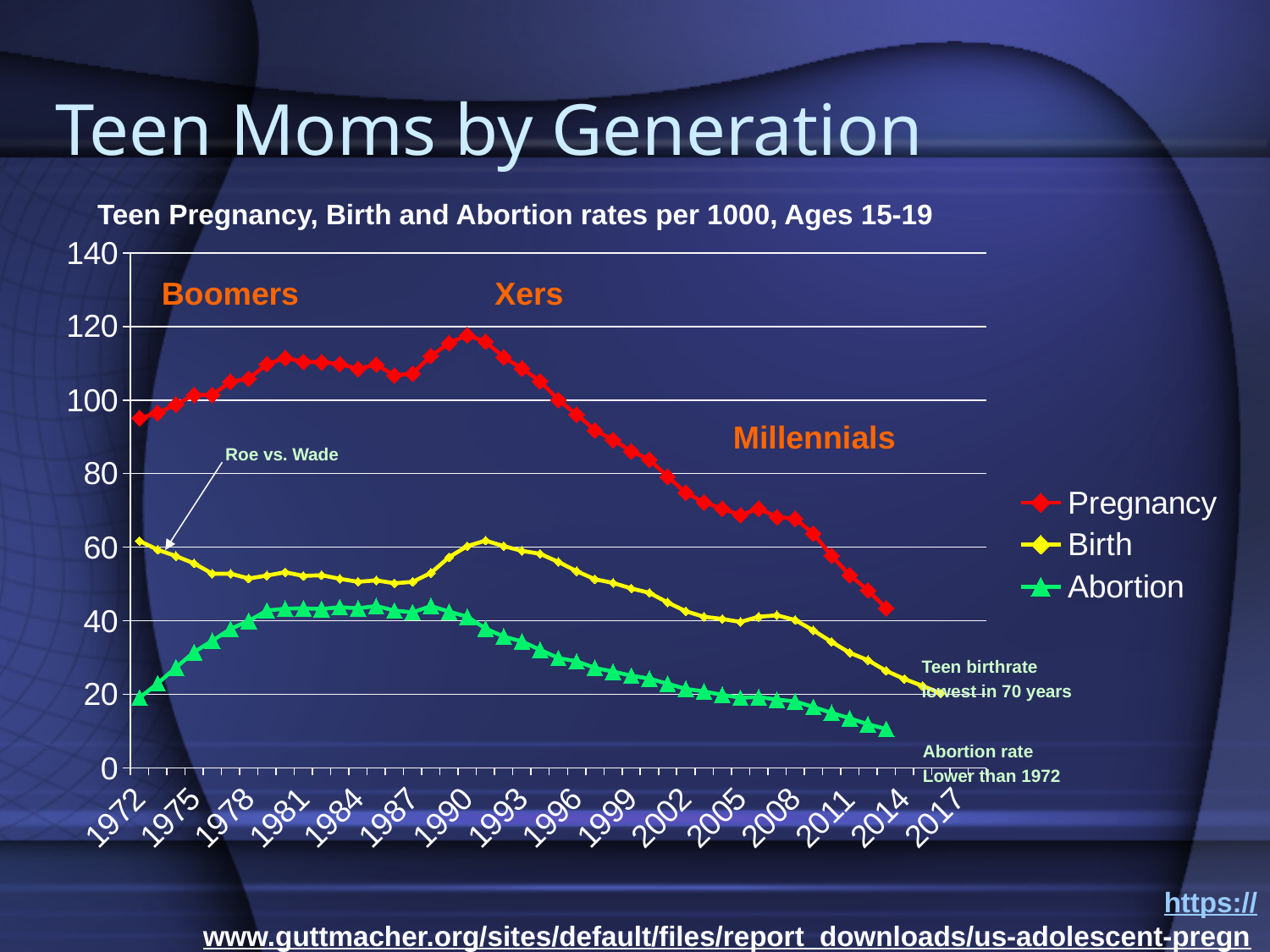
Which is larger in 2011, the Birth value or the Abortion value? Birth Which series has the highest values across the whole chart? Pregnancy Does the Pregnancy series rise or fall from 1990 to 2014? fall What kind of chart is shown on the slide? line chart Is the Pregnancy value for 1990 greater or less than 100? greater How many series does the legend list? 3 Is the Pregnancy value for 1972 greater or less than 100? less What are the three series listed in the legend? Pregnancy, Birth, Abortion Is the Abortion value for 2011 greater or less than 20? less What is the title of the chart? Teen Pregnancy, Birth and Abortion rates per 1000, Ages 15-19 Which series has the lowest values across the whole chart? Abortion